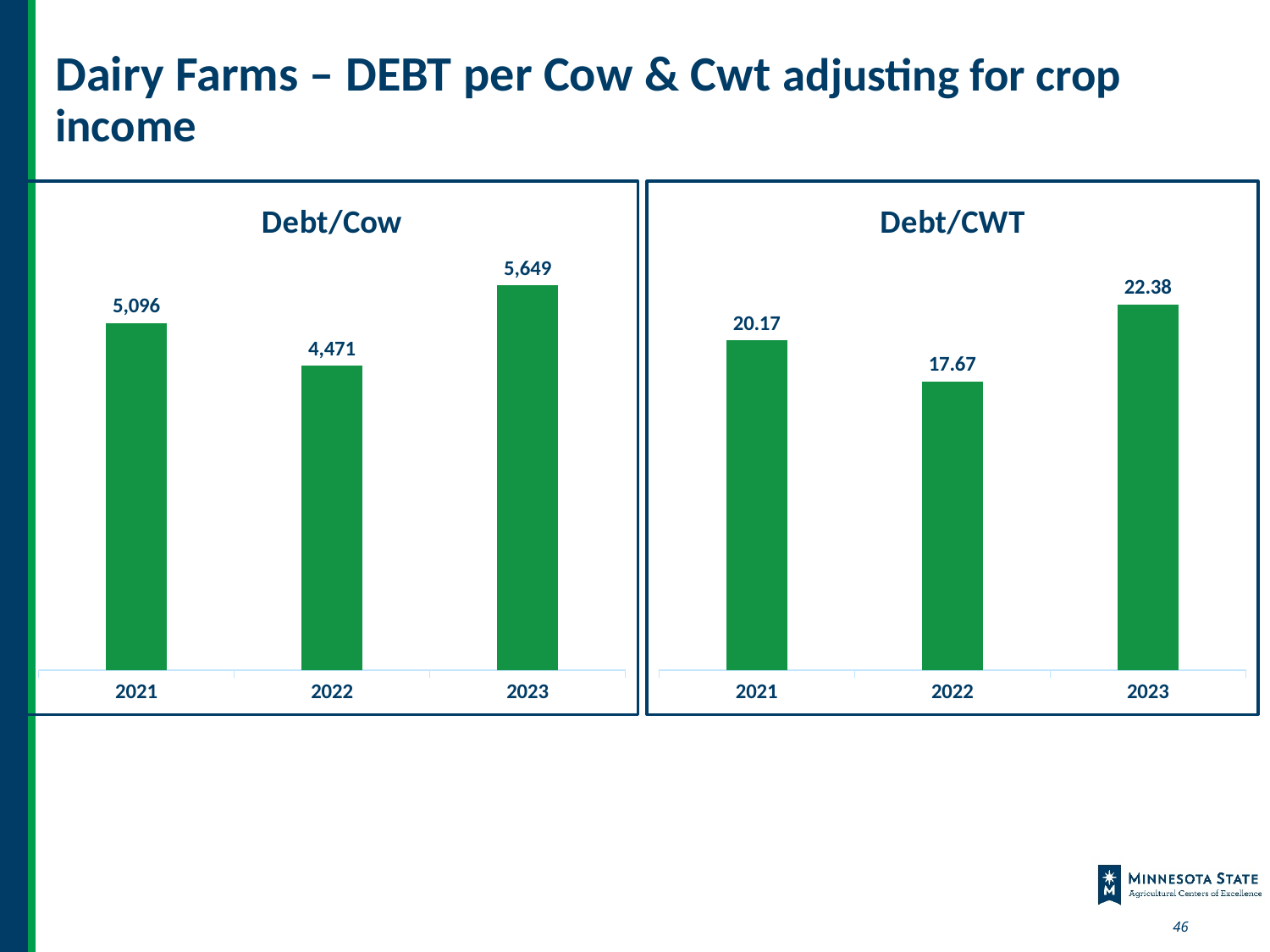
In the Debt/CWT chart, what is the value for 2023? 22.38 In the Debt/CWT chart, what is the difference between the 2021 and 2022 values? 2.50 In the Debt/CWT chart, which is larger, the value for 2021 or the value for 2023? 2023 What is the title of the chart on the left side of the slide? Debt/Cow In the Debt/Cow chart, what is the difference between the 2023 and 2022 values? 1,178 What kind of chart is the Debt/CWT chart? Bar chart In the Debt/Cow chart, which year has the highest value? 2023 In the Debt/CWT chart, which year has the lowest value? 2022 In the Debt/CWT chart, what is the value for 2022? 17.67 In the Debt/Cow chart, what is the value for 2022? 4,471 In the Debt/Cow chart, what is the value for 2021? 5,096 How many years are shown in the Debt/Cow chart? 3